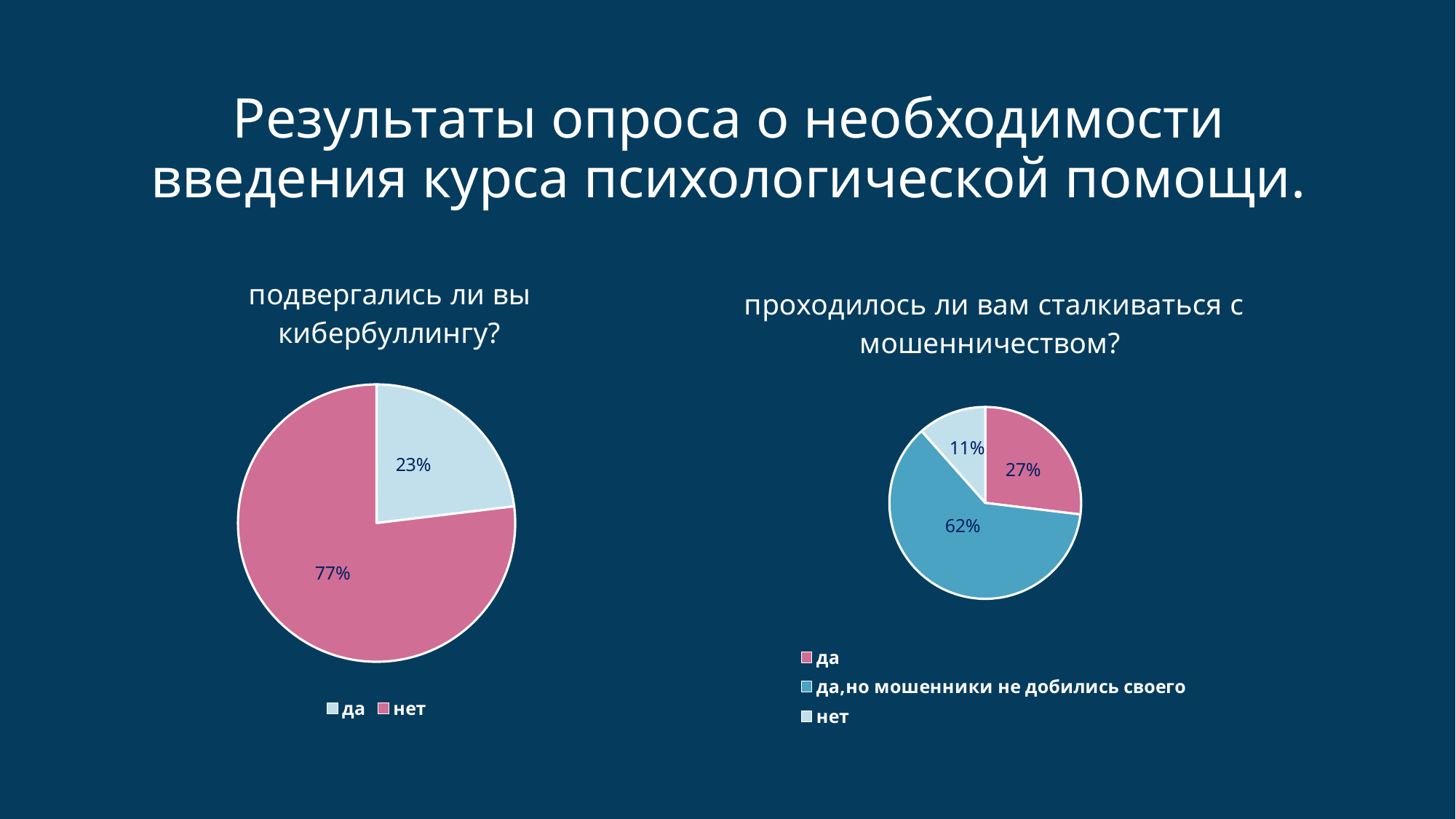
In the chart titled "проходилось ли вам сталкиваться с мошенничеством?", which is larger: the "да" slice or the "нет" slice? да How many slices does the chart titled "проходилось ли вам сталкиваться с мошенничеством?" have? 3 In the chart titled "подвергались ли вы кибербуллингу?", what is the difference between the "нет" and "да" shares? 54% In the chart titled "подвергались ли вы кибербуллингу?", what share of respondents answered "да"? 23% In the chart titled "подвергались ли вы кибербуллингу?", which answer has the largest slice? нет In the chart titled "проходилось ли вам сталкиваться с мошенничеством?", what share of respondents answered "да"? 27% How many entries does the legend of the chart titled "подвергались ли вы кибербуллингу?" list? 2 In the chart titled "подвергались ли вы кибербуллингу?", what share of respondents answered "нет"? 77% In the chart titled "проходилось ли вам сталкиваться с мошенничеством?", which answer has the smallest slice? нет In the chart titled "проходилось ли вам сталкиваться с мошенничеством?", what share of respondents answered "да, но мошенники не добились своего"? 62% In the chart titled "проходилось ли вам сталкиваться с мошенничеством?", what share of respondents answered "нет"? 11% What type of chart is the chart titled "подвергались ли вы кибербуллингу?"? Pie chart